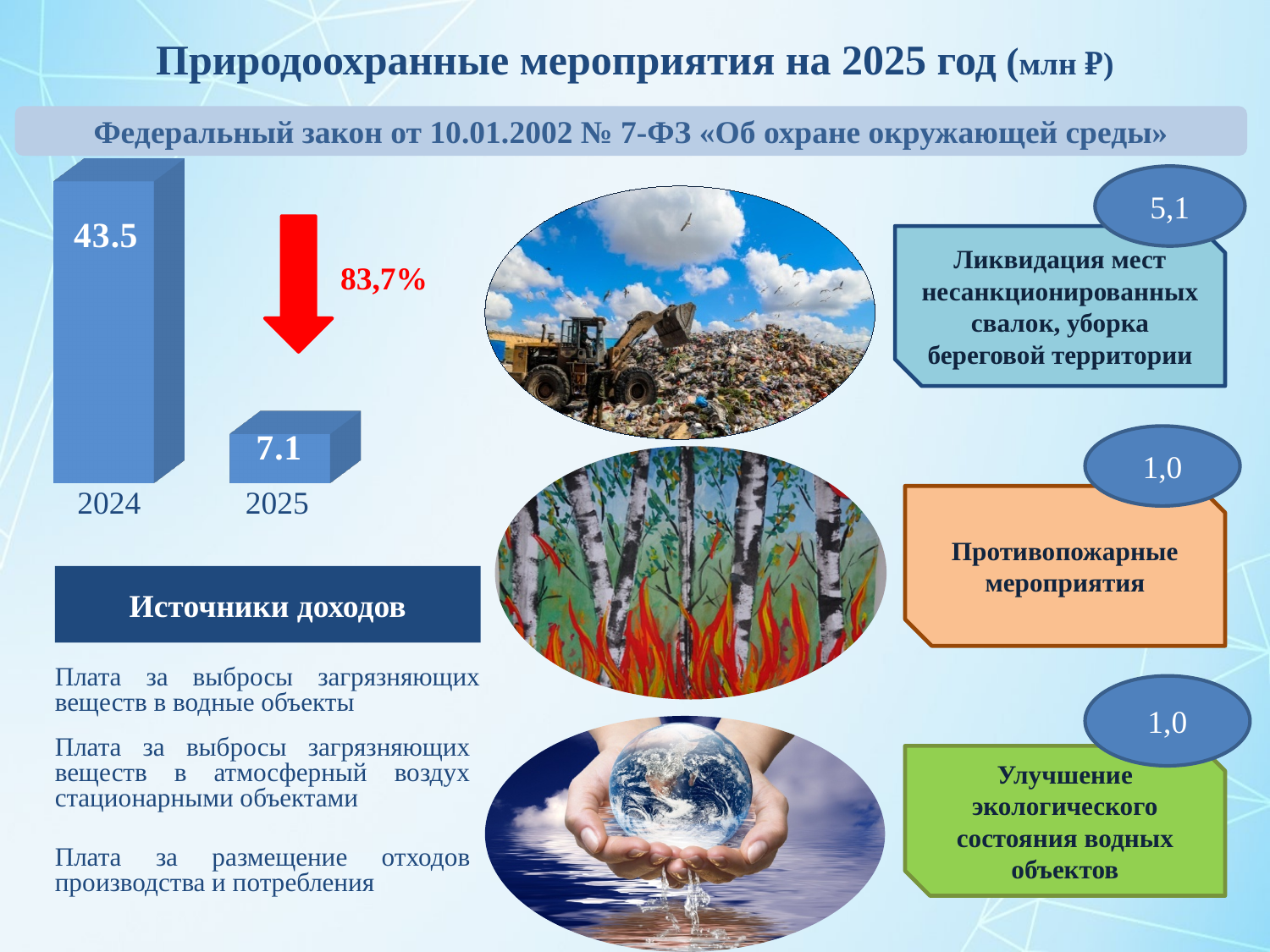
Do the values rise or fall from 2024 to 2025 in the bar chart? fall What is the value for 2024 in the bar chart? 43.5 Is the value for 2025 larger or smaller than the value for 2024? smaller What kind of chart is shown on the left of the slide? bar chart How many bars are shown in the bar chart? 2 What is the difference between the 2024 and 2025 values in the bar chart? 36.4 What percentage change is shown next to the red arrow beside the bar chart? 83,7% Which year has the higher value in the bar chart? 2024 Which year has the lower value in the bar chart? 2025 What is the value for 2025 in the bar chart? 7.1 What unit is given in the slide title for the values in the bar chart? млн ₽